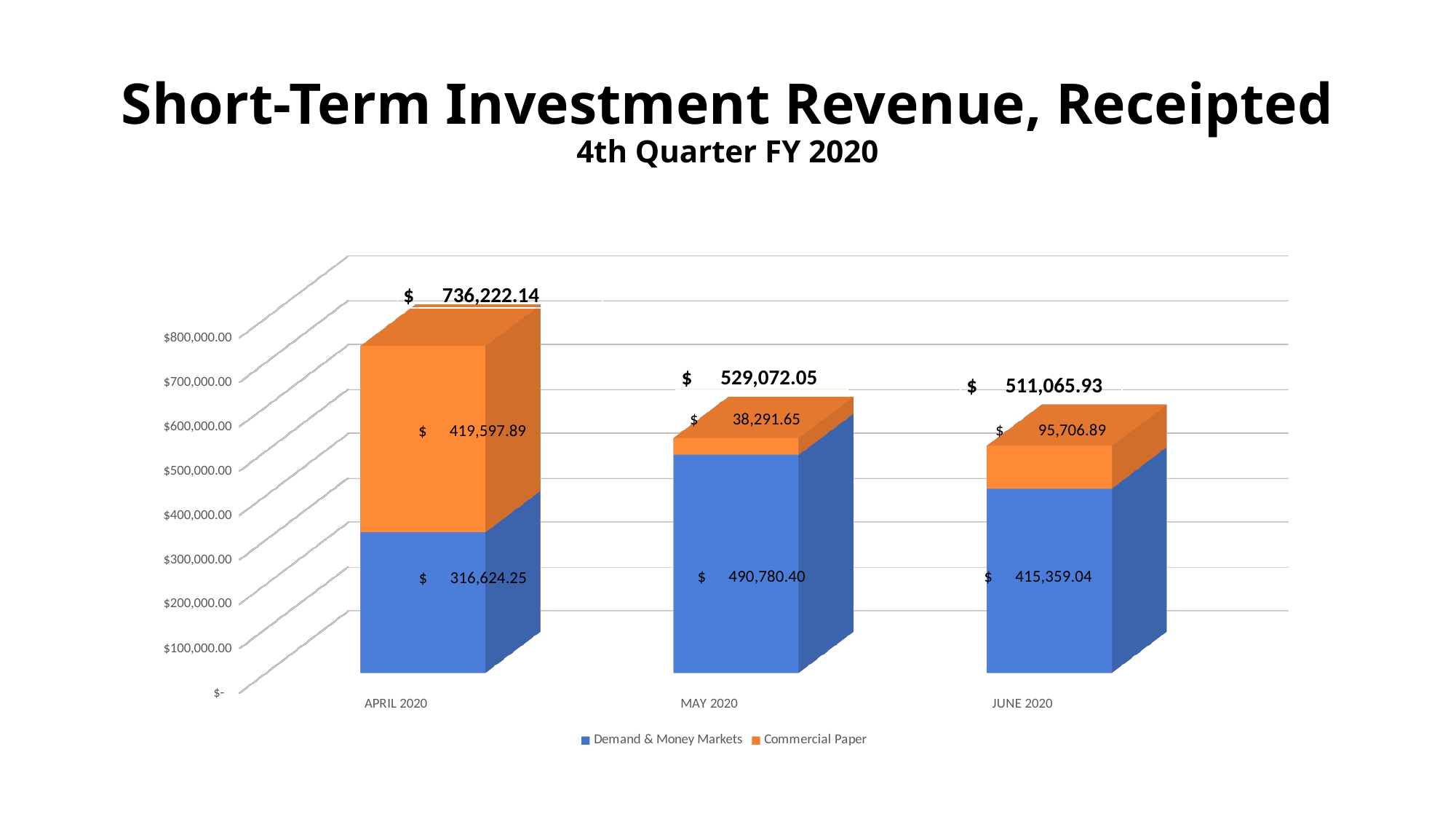
What type of chart is shown on the slide? Stacked bar chart What is the Commercial Paper value for June 2020? $95,706.89 What is the total short-term investment revenue for June 2020? $511,065.93 What is the Commercial Paper value for May 2020? $38,291.65 How many series does the legend list? 2 Which is larger in April 2020, Demand & Money Markets or Commercial Paper? Commercial Paper How many months are shown on the x axis? 3 Which month has the lowest Commercial Paper value? May 2020 Which month has the highest total revenue? April 2020 What is the Demand & Money Markets value for April 2020? $316,624.25 What is the difference between the Demand & Money Markets values for May 2020 and June 2020? $75,421.36 What is the total short-term investment revenue for April 2020? $736,222.14